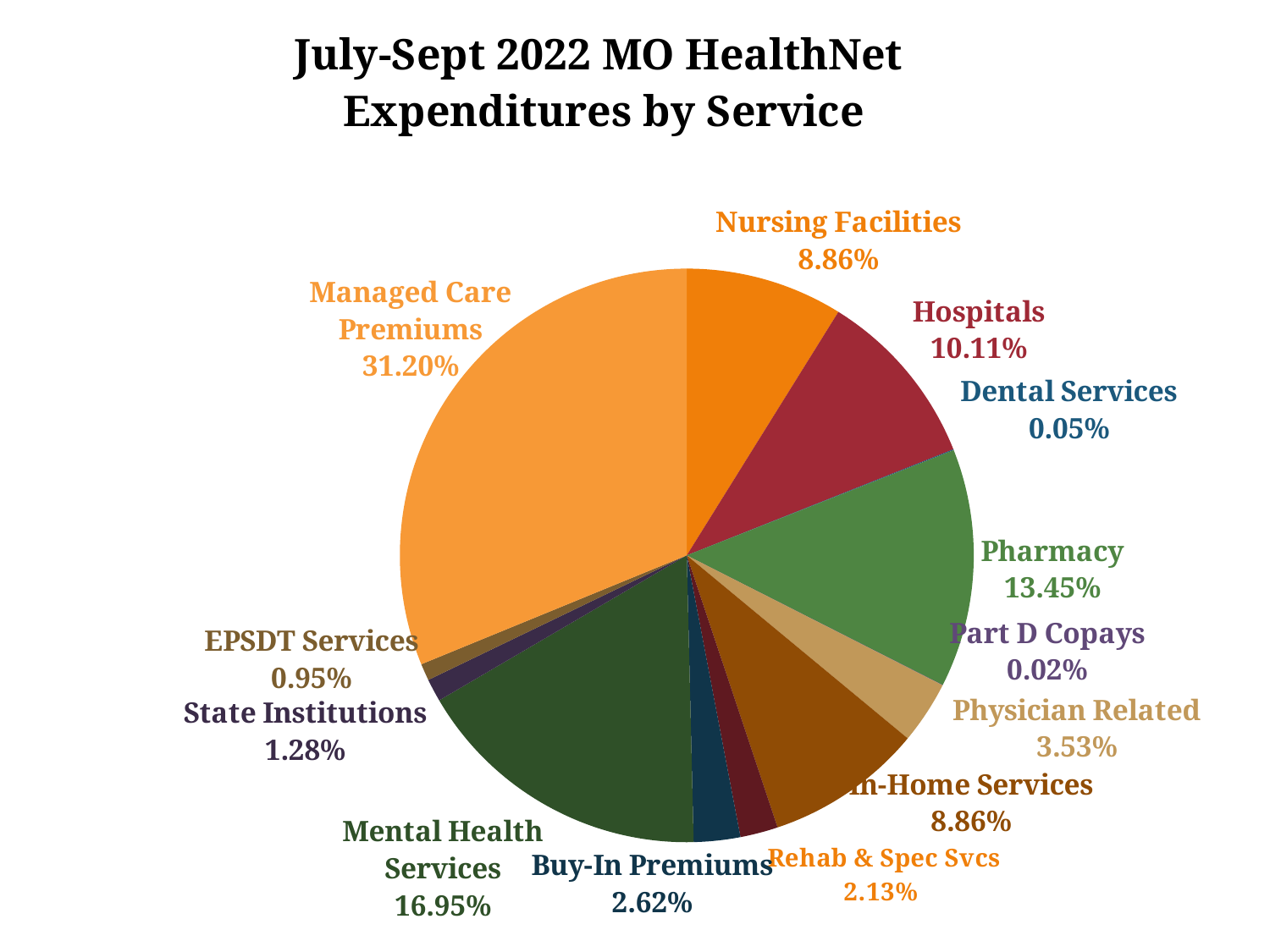
What is the value shown for Mental Health Services? 16.95% What is the title of the chart? July-Sept 2022 MO HealthNet Expenditures by Service What share of expenditures is Managed Care Premiums? 31.20% What percentage is shown for Hospitals? 10.11% Which is larger, the share for Pharmacy or the share for Hospitals? Pharmacy What percentage of expenditures goes to Pharmacy? 13.45% What is the difference in percentage points between Managed Care Premiums and Mental Health Services? 14.25 Which service category has the largest share of expenditures? Managed Care Premiums What kind of chart is shown on the slide? Pie chart What is the difference in percentage points between Physician Related and Rehab & Spec Svcs? 1.40 Which service category has the smallest share of expenditures? Part D Copays How many service categories are shown in the pie chart? 13